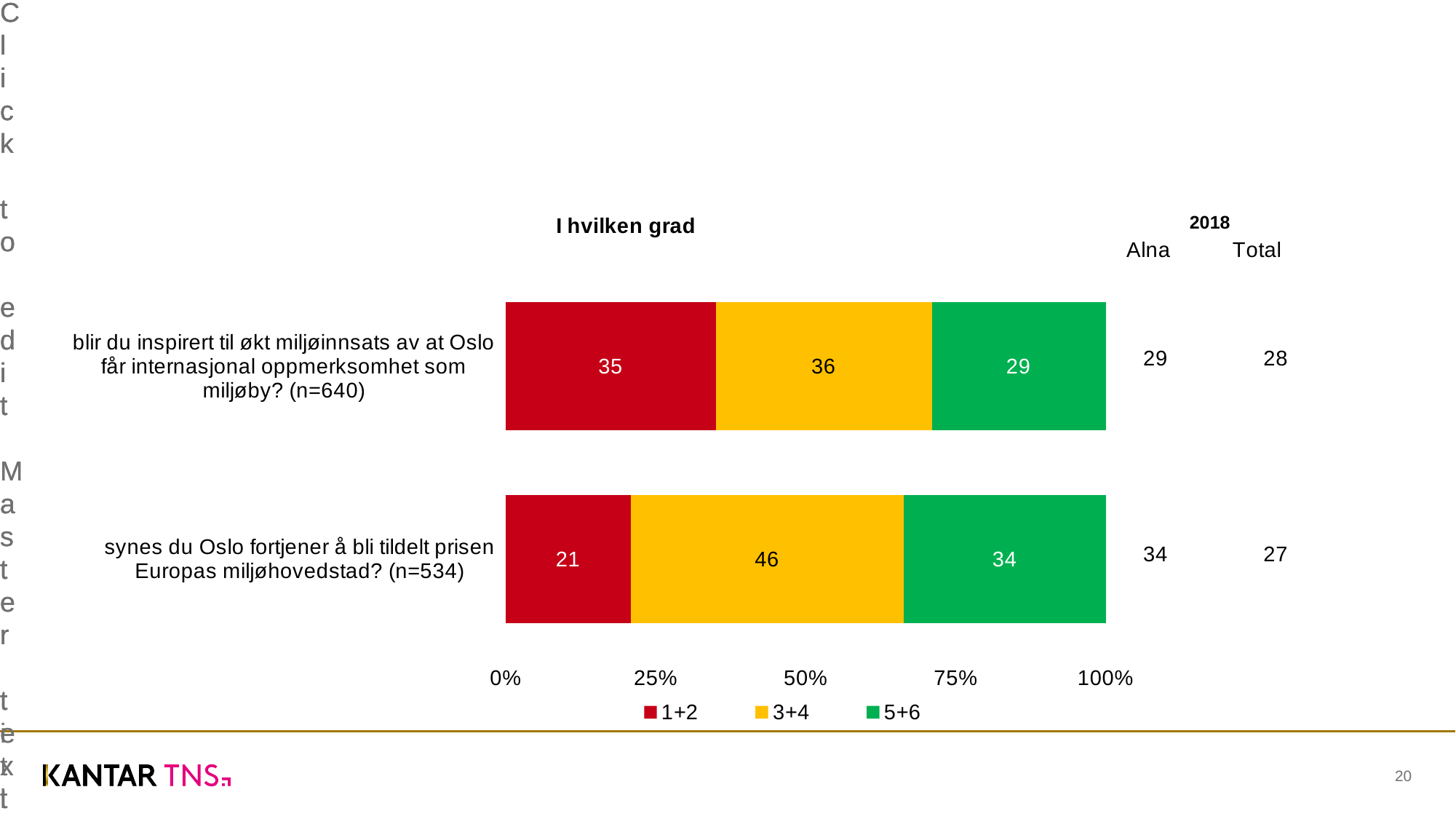
Which is larger: the 5+6 value for "blir du inspirert til økt miljøinnsats..." (n=640) or the 5+6 value for "synes du Oslo fortjener å bli tildelt prisen Europas miljøhovedstad?" (n=534)? synes du Oslo fortjener å bli tildelt prisen Europas miljøhovedstad? (n=534) Which series has the smallest value in the bar for "blir du inspirert til økt miljøinnsats av at Oslo får internasjonal oppmerksomhet som miljøby? (n=640)"? 5+6 How many questions (categories) are plotted in the chart? 2 What is the value of the 3+4 series for the question "synes du Oslo fortjener å bli tildelt prisen Europas miljøhovedstad? (n=534)"? 46 Which series has the largest value in the bar for "synes du Oslo fortjener å bli tildelt prisen Europas miljøhovedstad? (n=534)"? 3+4 What is the value of the 5+6 series for the question "blir du inspirert til økt miljøinnsats av at Oslo får internasjonal oppmerksomhet som miljøby? (n=640)"? 29 What is the difference between the 3+4 value and the 1+2 value for "synes du Oslo fortjener å bli tildelt prisen Europas miljøhovedstad? (n=534)"? 25 What is the 2018 Alna value shown next to the bar for "synes du Oslo fortjener å bli tildelt prisen Europas miljøhovedstad? (n=534)"? 34 What is the value of the 1+2 series for the question "synes du Oslo fortjener å bli tildelt prisen Europas miljøhovedstad? (n=534)"? 21 What kind of chart is shown on the slide? Stacked bar chart What is the value of the 1+2 series for the question "blir du inspirert til økt miljøinnsats av at Oslo får internasjonal oppmerksomhet som miljøby? (n=640)"? 35 How many series does the legend list? 3